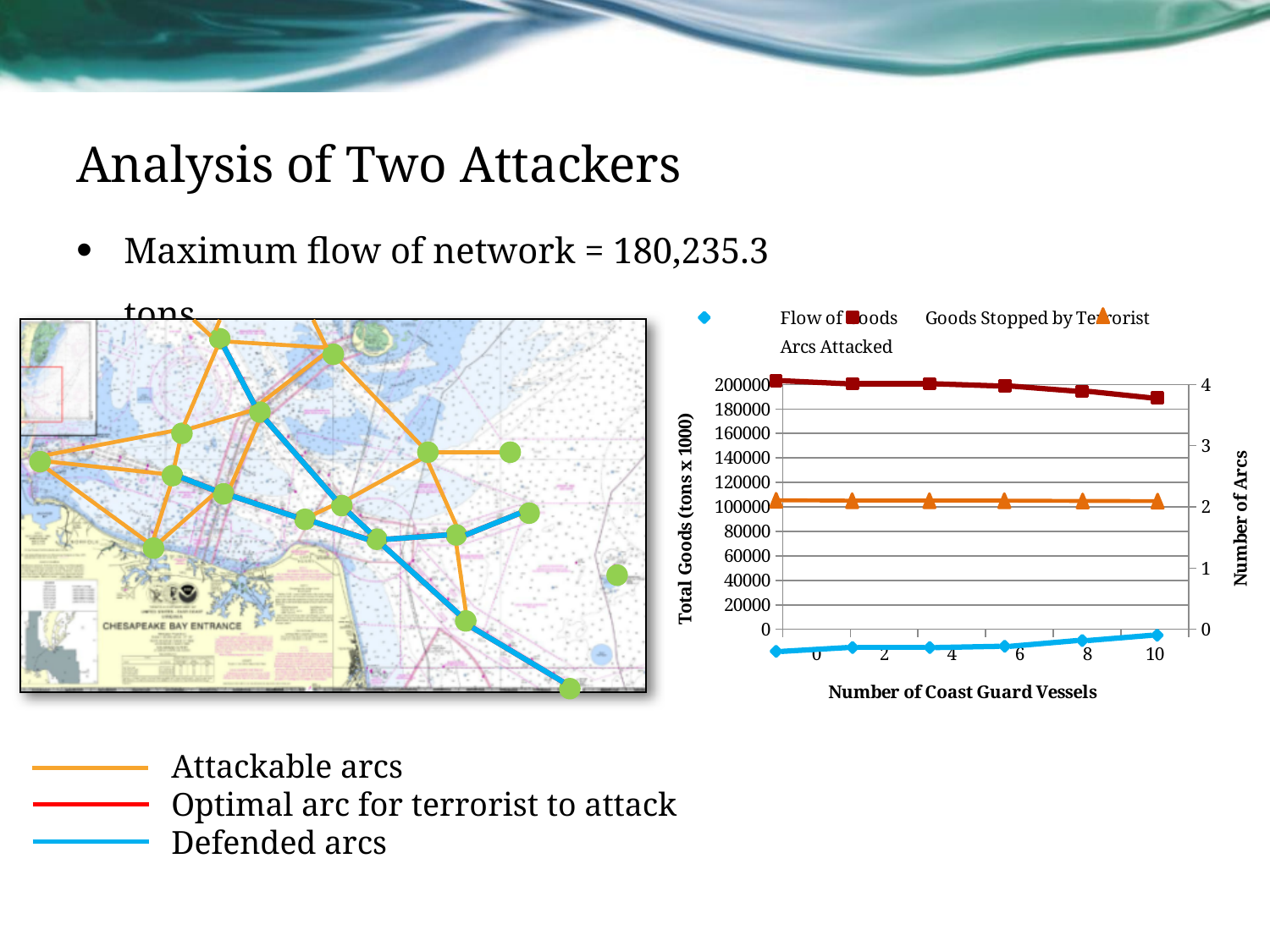
At which number of Coast Guard vessels is the Flow of Goods series lowest? 0 What is the title of the left vertical axis of the line chart? Total Goods (tons x 1000) Which series has the highest values on the line chart? Goods Stopped by Terrorist What kind of chart is shown on the right side of the slide? line chart At 6 Coast Guard vessels, which is larger: Flow of Goods or Goods Stopped by Terrorist? Goods Stopped by Terrorist How many series does the legend of the line chart list? 3 What is the title of the x axis of the line chart? Number of Coast Guard Vessels Does the Flow of Goods series rise or fall as the number of Coast Guard vessels increases? rise Is the Flow of Goods value at 0 Coast Guard vessels greater or less than 180000? less Is the Goods Stopped by Terrorist value at 4 Coast Guard vessels greater or less than 120000? greater Is the Goods Stopped by Terrorist value at 8 Coast Guard vessels greater or less than 80000? greater How many data points are plotted for the Flow of Goods series? 6